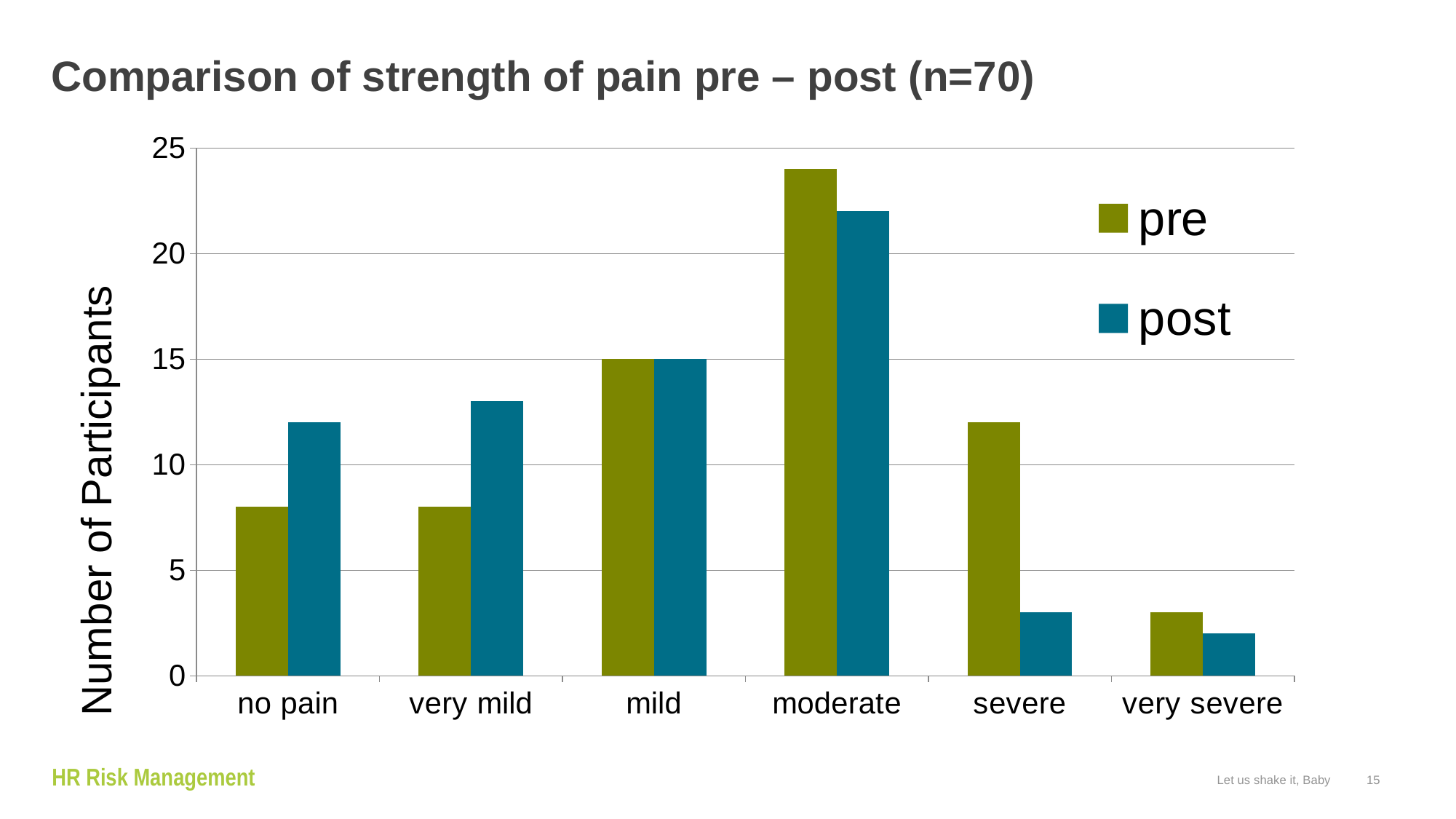
Which category has the lowest value in the post series? very severe Is the pre value for moderate greater or less than 20? greater For no pain, which is larger, the pre value or the post value? post Which category has the highest value in the pre series? moderate Is the post value for severe greater or less than 5? less How many series does the legend list? 2 What kind of chart is shown on the slide? bar chart How many pain categories are shown on the x axis? 6 Is the post value for very mild greater or less than 10? greater For severe, which is larger, the pre value or the post value? pre What is the label of the y axis? Number of Participants What is the value for mild in the pre series? 15